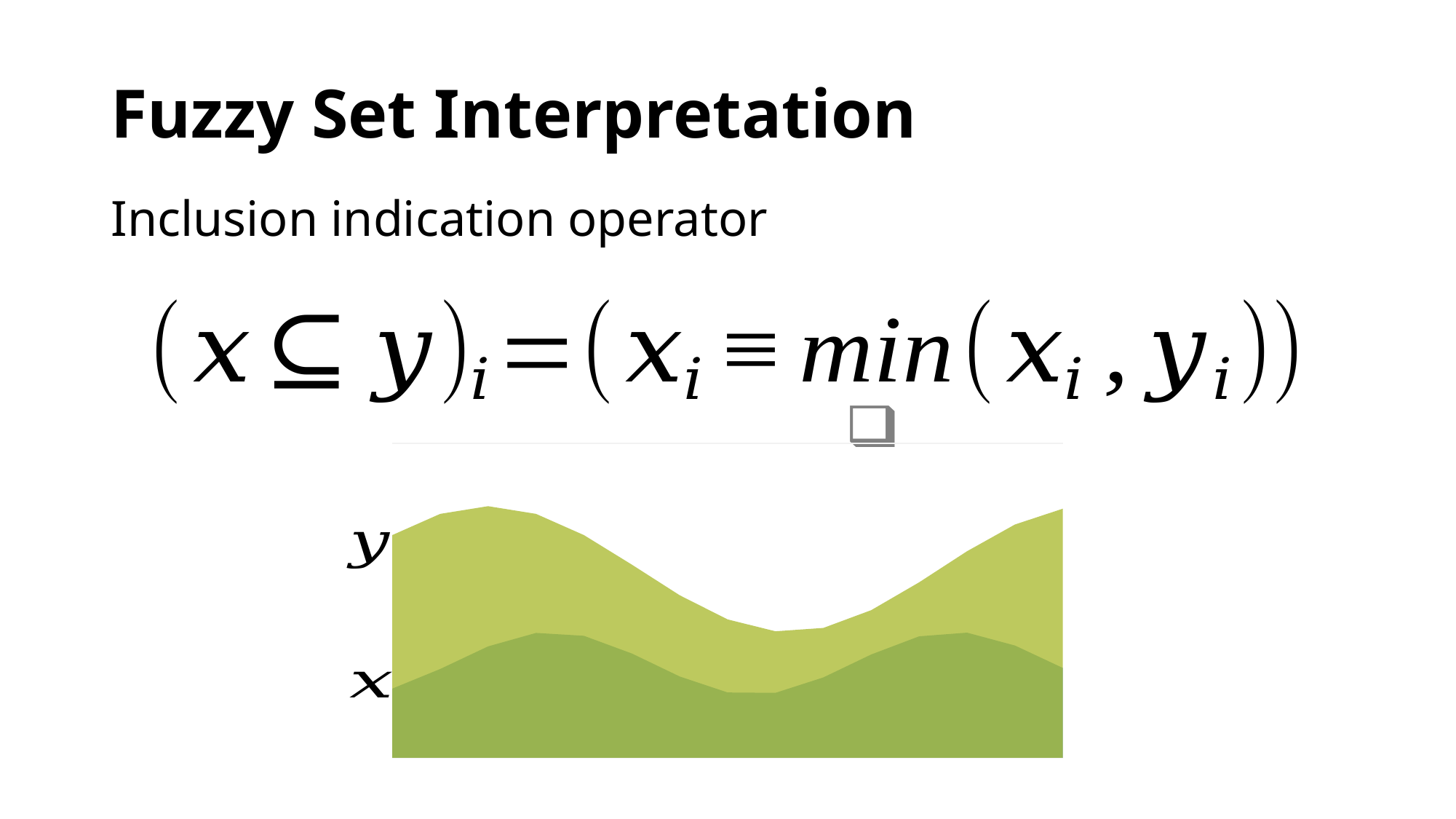
Is the x series ever above the y series in the chart? no Which series has the larger values across the whole chart, x or y? y How many series are plotted in the area chart? 2 What are the labels of the two series in the chart? y and x What kind of chart is shown at the bottom of the slide? area chart Does the y series rise or fall between its left edge and its first peak? rise Does the y series rise or fall toward the right end of the chart? rise Does the x series rise or fall toward the right end of the chart? fall Which series is drawn in the lighter green shade? y